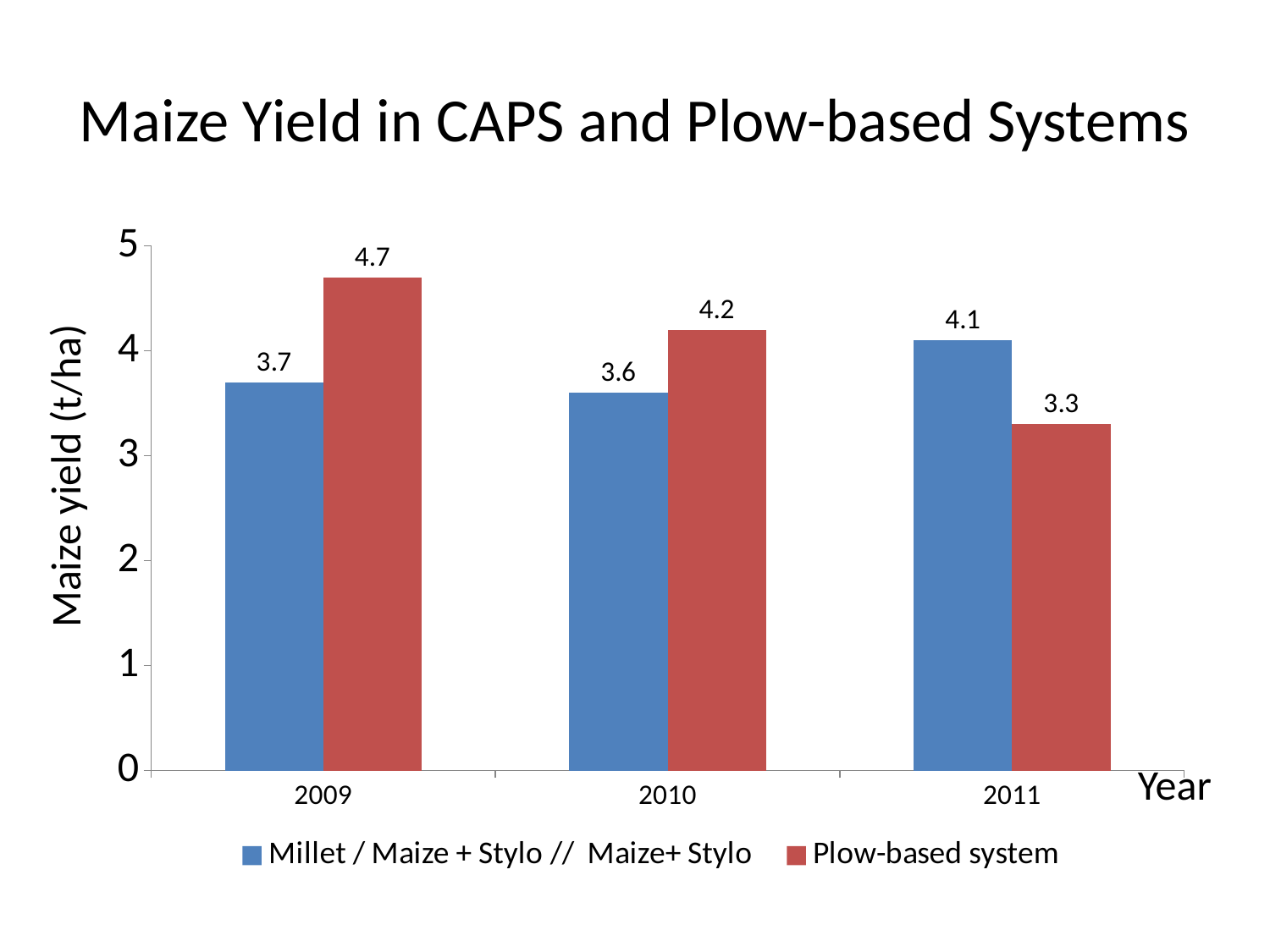
What is the maize yield for Millet / Maize + Stylo // Maize+ Stylo in 2011? 4.1 Does the Plow-based system yield rise or fall from 2009 to 2011? fall In which year is the Millet / Maize + Stylo // Maize+ Stylo yield lowest? 2010 What is the difference between the Plow-based system yield and the Millet / Maize + Stylo // Maize+ Stylo yield in 2009? 1.0 How many series does the legend list? 2 What is the maize yield for the Plow-based system in 2009? 4.7 Is the Plow-based system yield in 2011 greater or less than 4? less Which system has the higher maize yield in 2011? Millet / Maize + Stylo // Maize+ Stylo What is the maize yield for the Plow-based system in 2010? 4.2 How many years are shown on the x axis? 3 In which year is the Plow-based system yield highest? 2009 What kind of chart is shown on the slide? bar chart